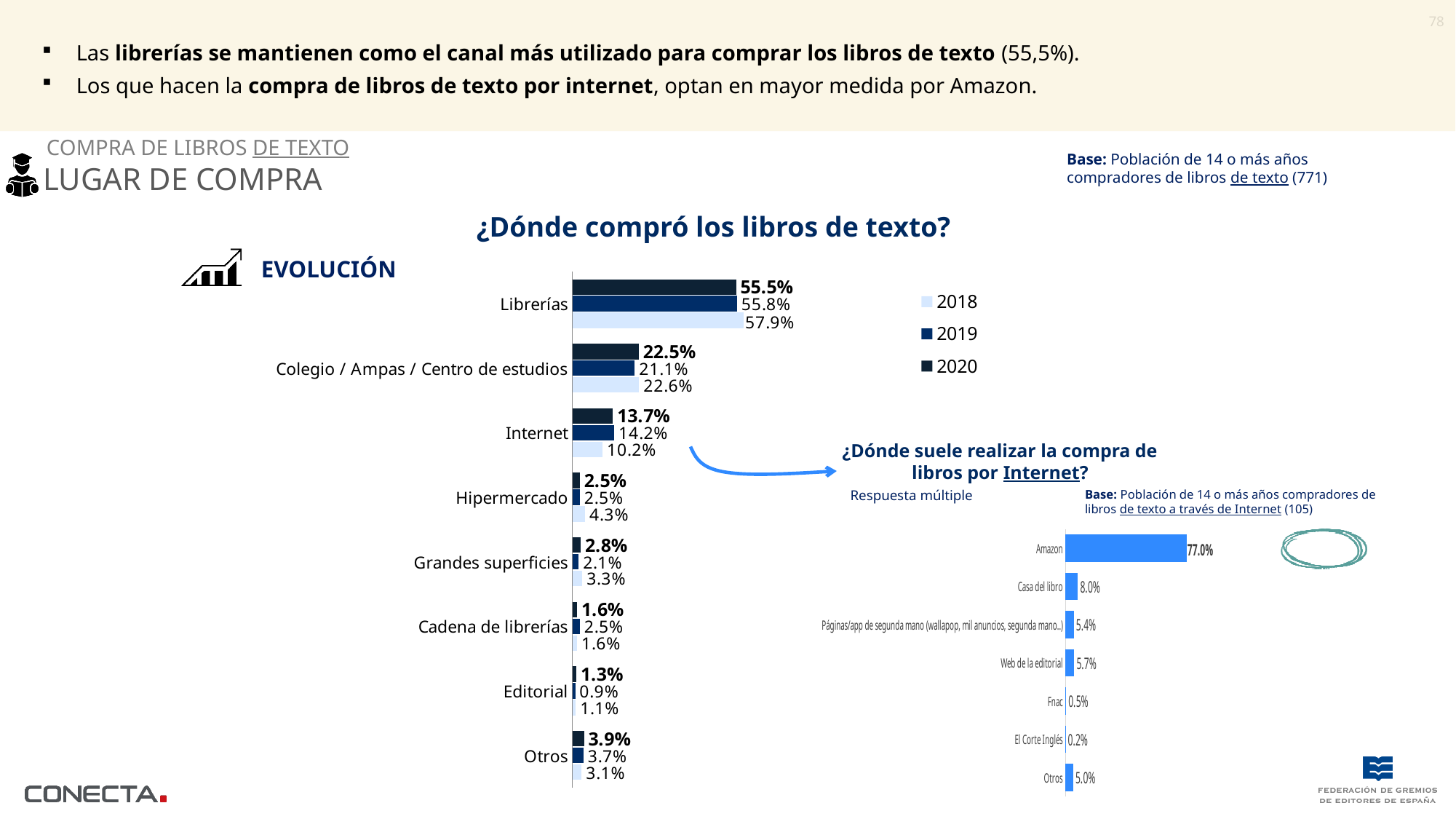
In the chart '¿Dónde compró los libros de texto?', what is the 2020 value for Librerías? 55.5% In the chart '¿Dónde compró los libros de texto?', which category has the highest 2020 value? Librerías In the chart '¿Dónde suele realizar la compra de libros por Internet?', which category has the lowest value? El Corte Inglés In the chart '¿Dónde compró los libros de texto?', how many categories are shown? 8 In the chart '¿Dónde suele realizar la compra de libros por Internet?', what is the value for Amazon? 77.0% What kind of chart is '¿Dónde suele realizar la compra de libros por Internet?'? bar chart In the chart '¿Dónde compró los libros de texto?', which category has the lowest 2020 value? Editorial In the chart '¿Dónde compró los libros de texto?', what is the 2019 value for Colegio / Ampas / Centro de estudios? 21.1% In the chart '¿Dónde compró los libros de texto?', how many series does the legend list? 3 In the chart '¿Dónde compró los libros de texto?', what is the 2018 value for Internet? 10.2% In the chart '¿Dónde compró los libros de texto?', is the 2019 value for Internet larger or smaller than the 2020 value for Internet? larger In the chart '¿Dónde compró los libros de texto?', what is the difference between the 2018 and 2020 values for Librerías? 2.4%